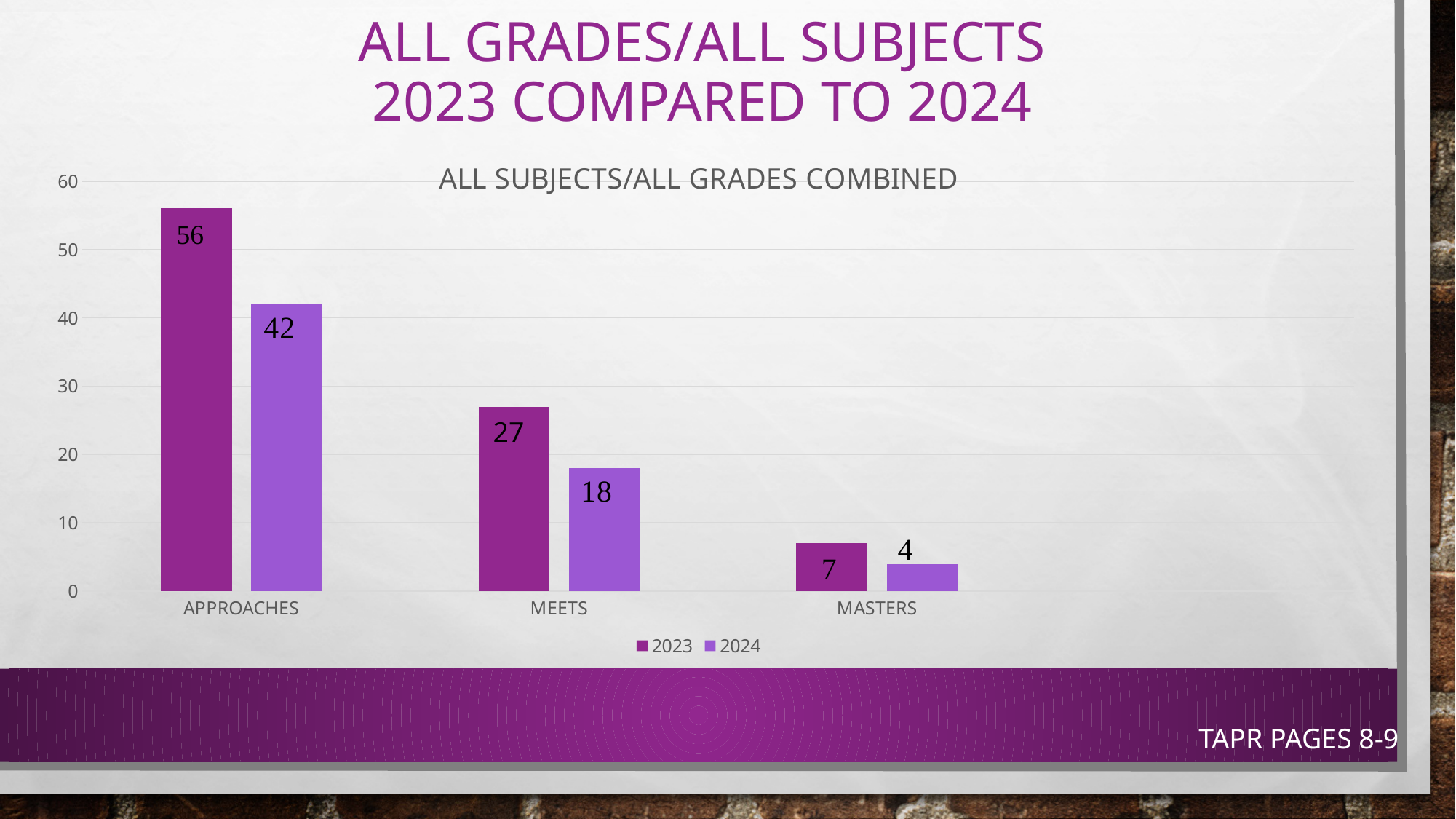
What is the 2024 value for Meets? 18 How many series does the legend list? 2 What is the 2024 value for Masters? 4 What is the difference between the 2023 and 2024 values for Approaches? 14 What is the 2023 value for Approaches? 56 Which is larger, the 2023 value for Masters or the 2024 value for Masters? 2023 Which category has the highest 2023 value? Approaches Which category has the lowest 2024 value? Masters What kind of chart is shown on the slide? Bar chart How many categories are shown on the x axis? 3 What is the difference between the 2023 and 2024 values for Meets? 9 What is the title of the chart? All Subjects/All Grades Combined